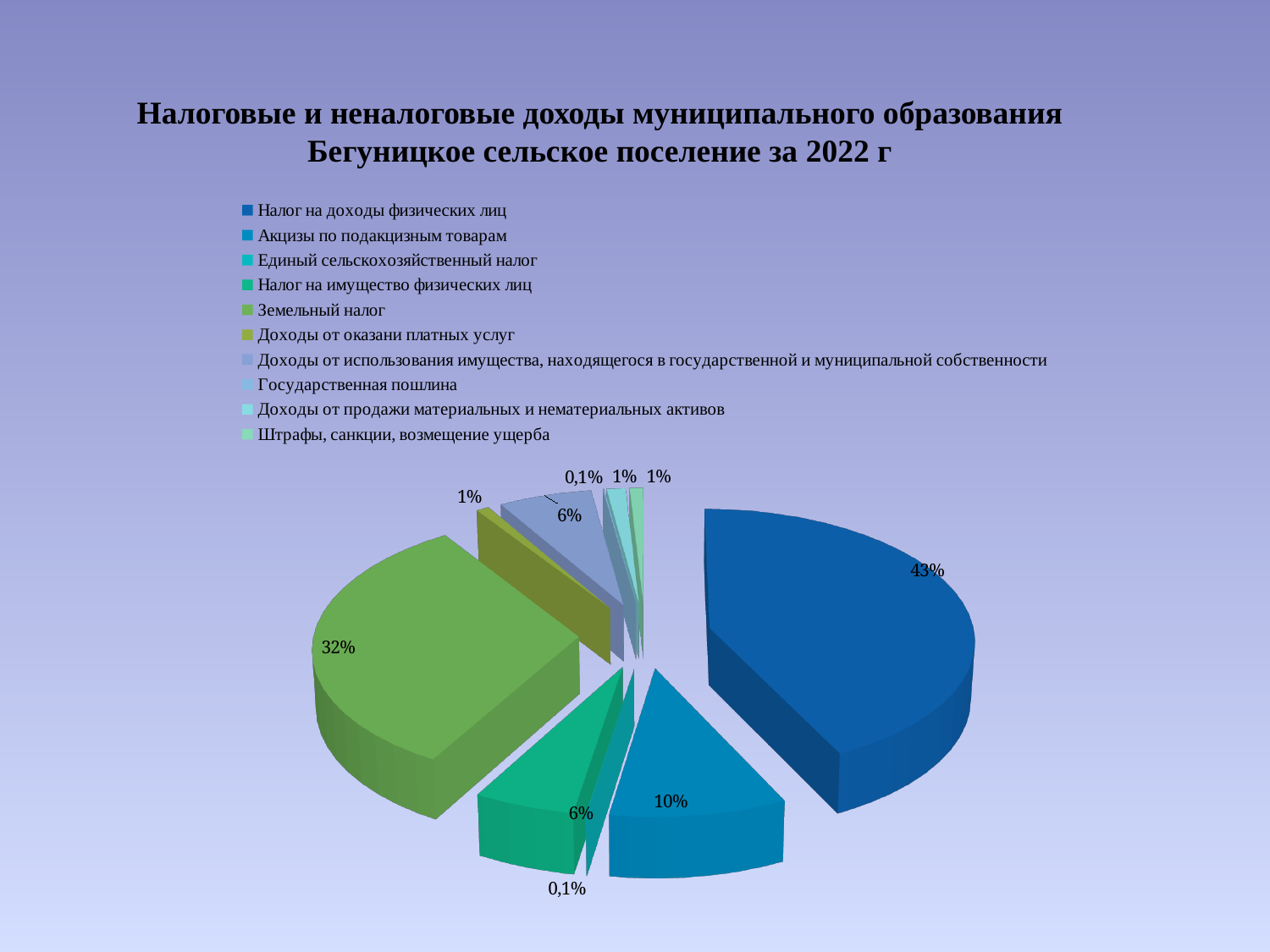
What colour is the slice for Земельный налог? green What is the difference in percentage points between the shares of Налог на доходы физических лиц and Земельный налог? 11 Which category has the largest share of the pie? Налог на доходы физических лиц What share of the pie does Земельный налог have? 32% What share of the pie does Налог на доходы физических лиц have? 43% Which is larger: the share of Акцизы по подакцизным товарам or the share of Налог на имущество физических лиц? Акцизы по подакцизным товарам What share of the pie does Налог на имущество физических лиц have? 6% How many categories does the legend list? 10 What is the title of the chart? Налоговые и неналоговые доходы муниципального образования Бегуницкое сельское поселение за 2022 г What kind of chart is shown on the slide? pie chart